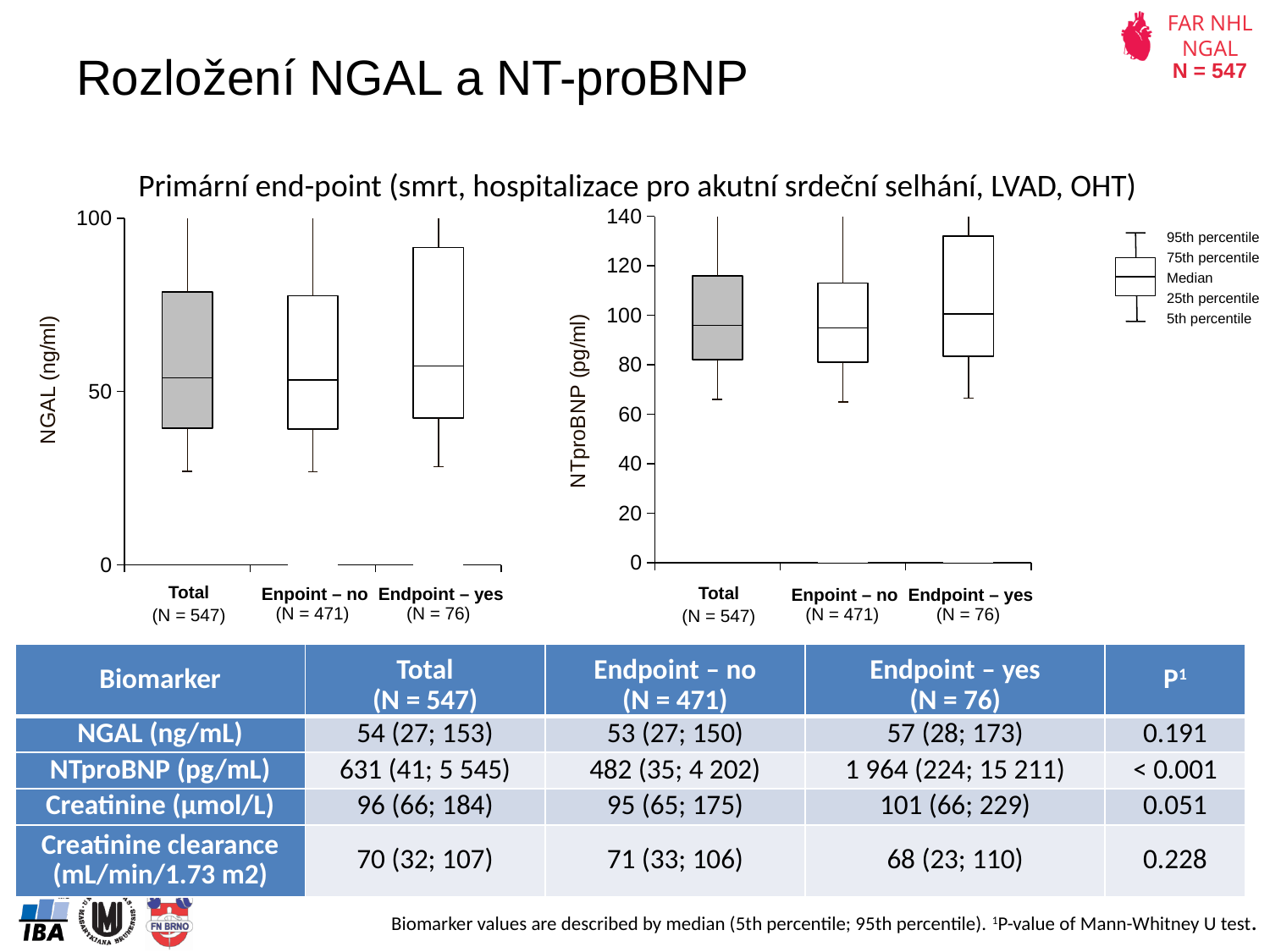
In the NTproBNP (pg/ml) chart, is the 25th percentile for Endpoint – no greater or less than 100? less In the NTproBNP (pg/ml) chart, is the 5th percentile for Total greater or less than 80? less In the NTproBNP (pg/ml) chart, which category has the highest 75th percentile? Endpoint – yes How many categories are shown on the x axis of the NTproBNP (pg/ml) chart? 3 How many entries does the percentile legend on the right list? 5 What kind of chart is the NGAL (ng/ml) chart on the left? box plot In the NGAL (ng/ml) chart, which category has the highest 75th percentile? Endpoint – yes In the NGAL (ng/ml) chart, which category's box is shaded grey? Total In the NGAL (ng/ml) chart, is the 25th percentile for Total greater or less than 50? less In the NTproBNP (pg/ml) chart, is the 75th percentile larger for Total or for Endpoint – yes? Endpoint – yes